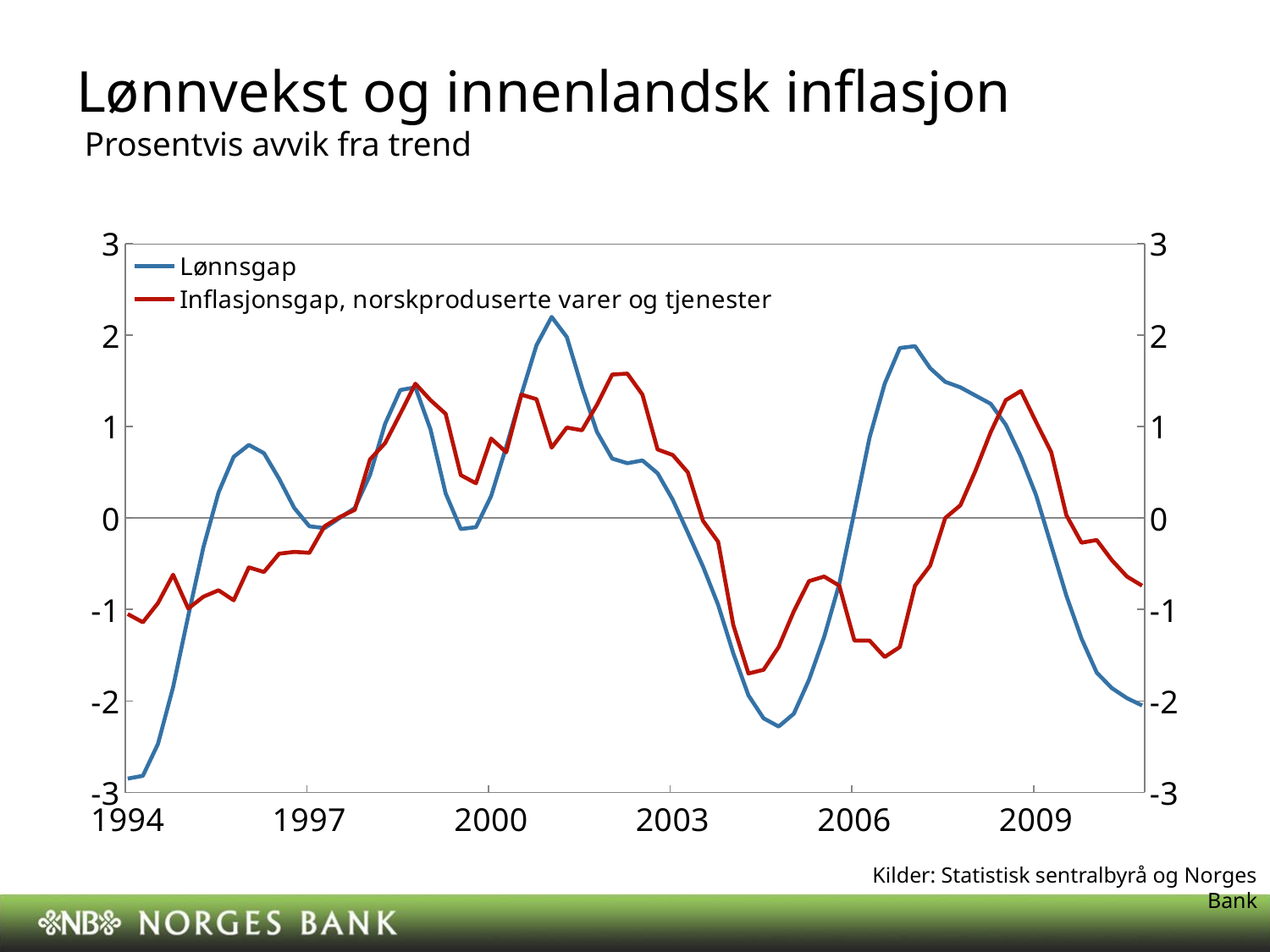
Does the Lønnsgap series rise or fall between 2009 and the end of the chart? fall Is the highest value reached by Lønnsgap greater or less than 2? greater What is the title of the chart on the slide? Lønnvekst og innenlandsk inflasjon At 2006, which series has the higher value, Lønnsgap or Inflasjonsgap, norskproduserte varer og tjenester? Lønnsgap How many series does the legend list? 2 What kind of chart is shown on the slide? line chart Is the value of Inflasjonsgap, norskproduserte varer og tjenester at 2006 greater or less than -1? less Which colour is used for the Lønnsgap series? blue At 1994, which series has the higher value, Lønnsgap or Inflasjonsgap, norskproduserte varer og tjenester? Inflasjonsgap, norskproduserte varer og tjenester Is the value of Lønnsgap at 1994 greater or less than -2? less